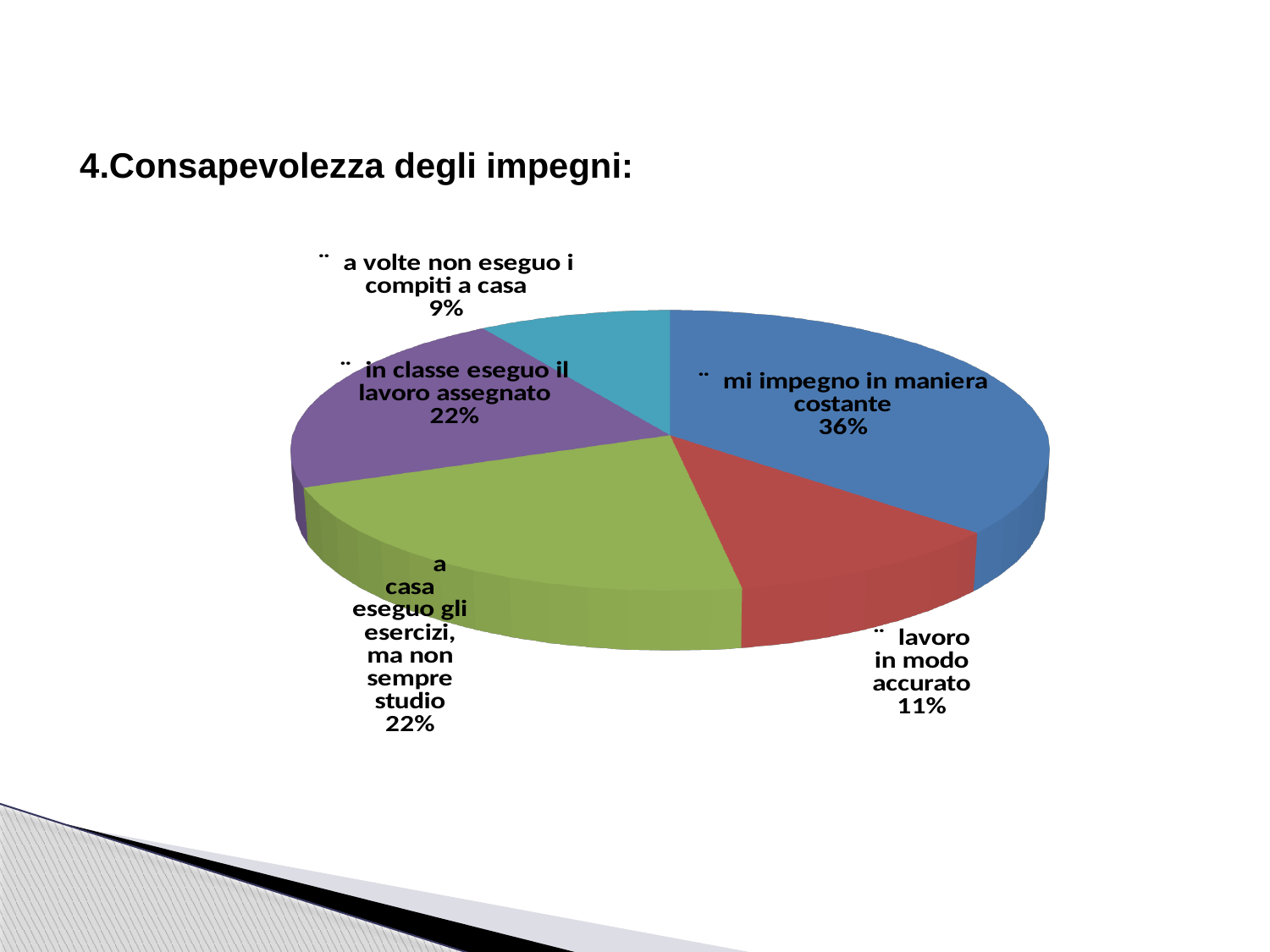
What share of the pie is labelled "lavoro in modo accurato"? 11% What kind of chart is shown on the slide? pie chart Which is larger, the slice for "lavoro in modo accurato" or the slice for "a volte non eseguo i compiti a casa"? lavoro in modo accurato What is the difference in percentage points between "mi impegno in maniera costante" and "lavoro in modo accurato"? 25 What share of the pie is labelled "mi impegno in maniera costante"? 36% Which slice of the pie is the largest? mi impegno in maniera costante What share of the pie is labelled "a volte non eseguo i compiti a casa"? 9% What is the title shown above the chart on the slide? 4.Consapevolezza degli impegni: How many slices does the pie chart have? 5 Which slice of the pie is the smallest? a volte non eseguo i compiti a casa